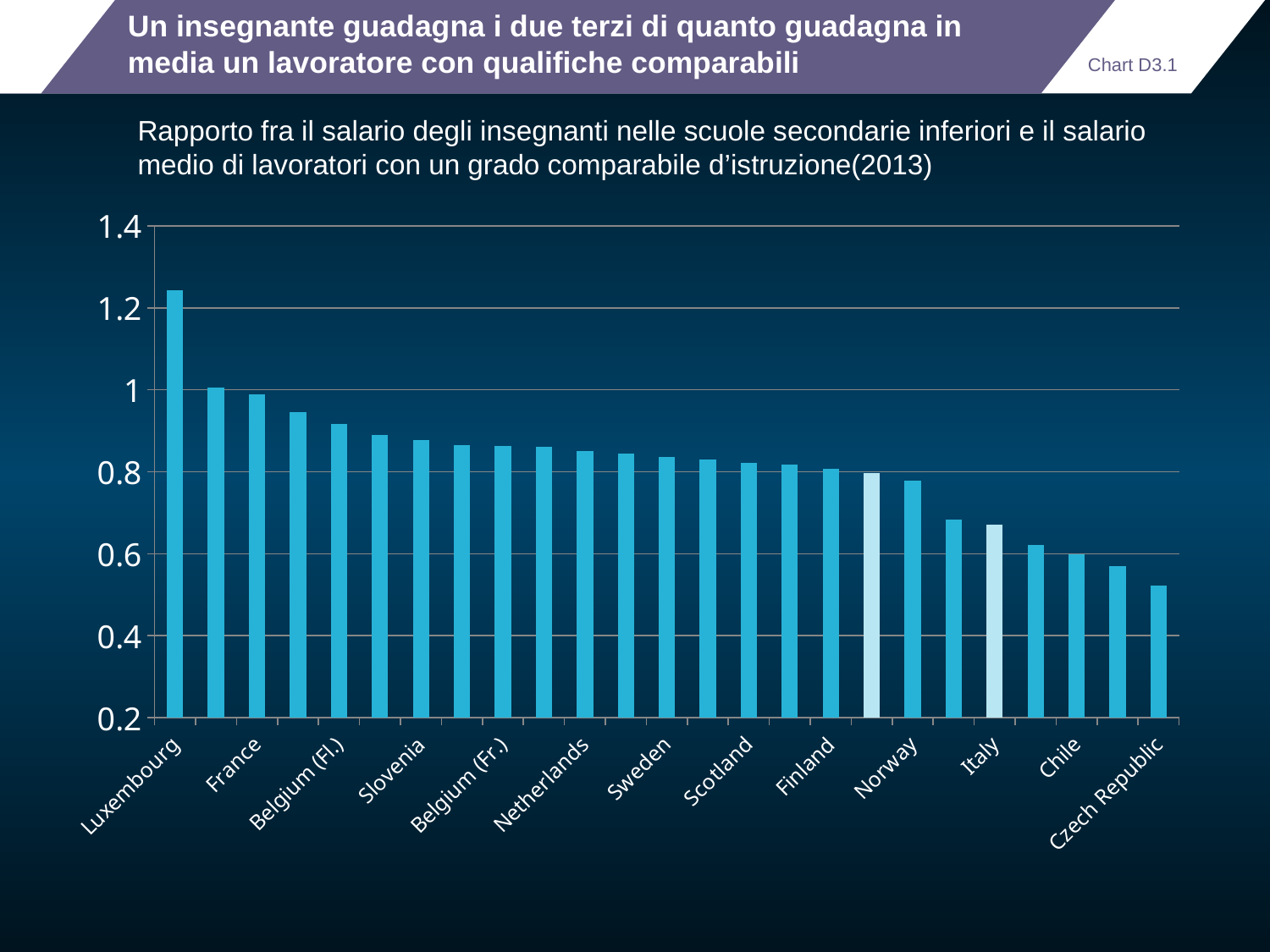
Is the value for Luxembourg greater or less than 1? greater Which has a larger value, Slovenia or Italy? Slovenia Which country has the lowest ratio in the chart? Czech Republic Do the values rise or fall from left to right along the x axis? fall Which country has the highest ratio in the chart? Luxembourg Which has a larger value, Czech Republic or Finland? Finland What kind of chart is shown on the slide? bar chart Is the value for Belgium (Fl.) greater or less than 0.8? greater Is the value for Netherlands greater or less than 0.8? greater Which labelled country's bar is drawn in a lighter colour than the others? Italy